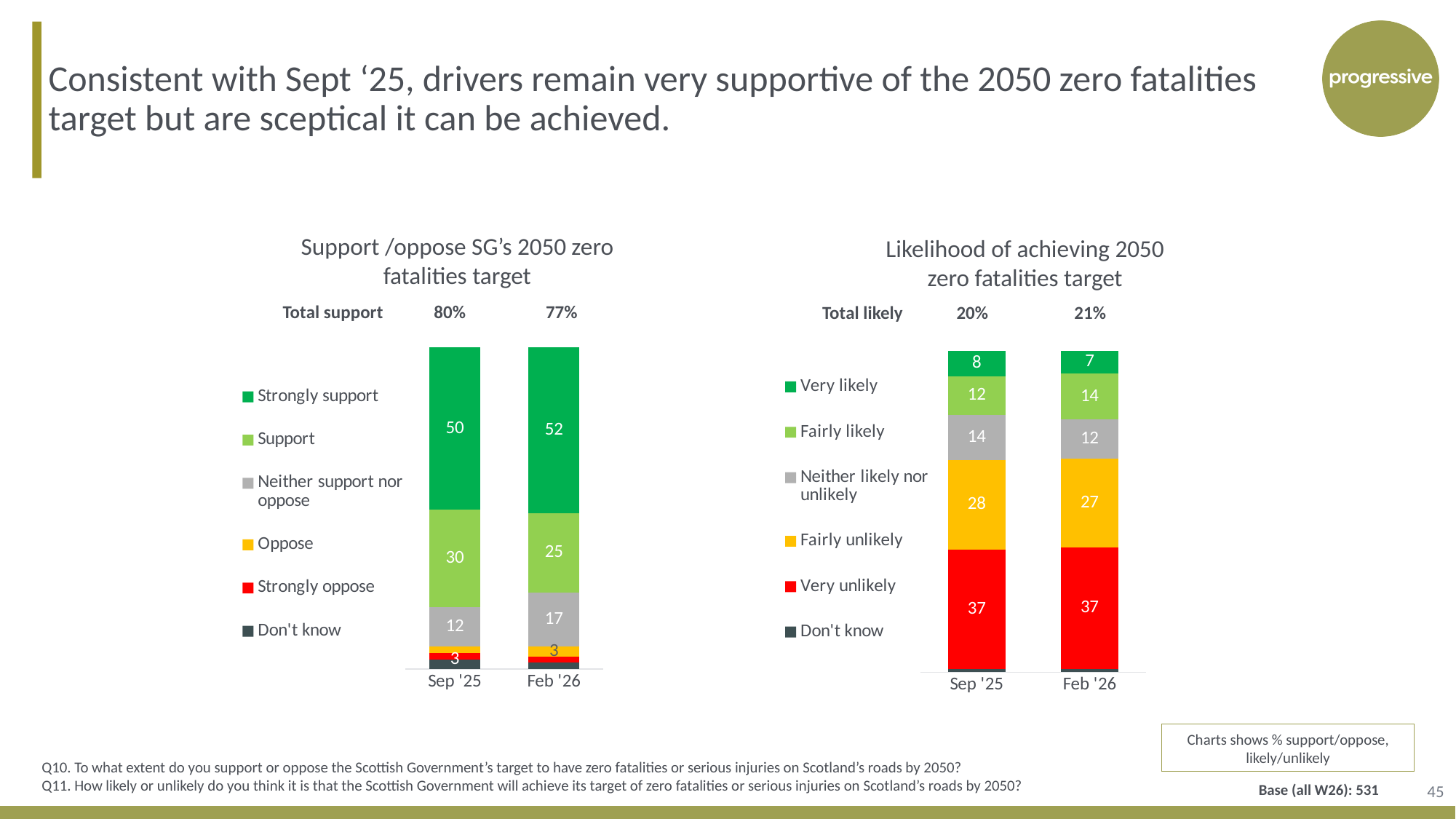
In the 'Likelihood of achieving 2050 zero fatalities target' chart, is the Fairly unlikely value larger in Sep '25 or Feb '26? Sep '25 How many series does the legend of the 'Likelihood of achieving 2050 zero fatalities target' chart list? 6 In the 'Likelihood of achieving 2050 zero fatalities target' chart, what is the Total likely figure shown for Sep '25? 20% In the 'Support /oppose SG's 2050 zero fatalities target' chart, what is the value for Support in Sep '25? 30 In the 'Support /oppose SG's 2050 zero fatalities target' chart, what is the Total support figure shown for Feb '26? 77% In the 'Likelihood of achieving 2050 zero fatalities target' chart, what is the value for Fairly likely in Sep '25? 12 In the 'Likelihood of achieving 2050 zero fatalities target' chart, which segment is the largest in the Sep '25 bar? Very unlikely What kind of chart is the 'Support /oppose SG's 2050 zero fatalities target' chart? Stacked bar chart In the 'Support /oppose SG's 2050 zero fatalities target' chart, what is the value for Strongly support in Feb '26? 52 How many bars (time points) are shown in the 'Support /oppose SG's 2050 zero fatalities target' chart? 2 In the 'Likelihood of achieving 2050 zero fatalities target' chart, what is the value for Very unlikely in Feb '26? 37 In the 'Support /oppose SG's 2050 zero fatalities target' chart, what is the difference between the Neither support nor oppose values for Feb '26 and Sep '25? 5